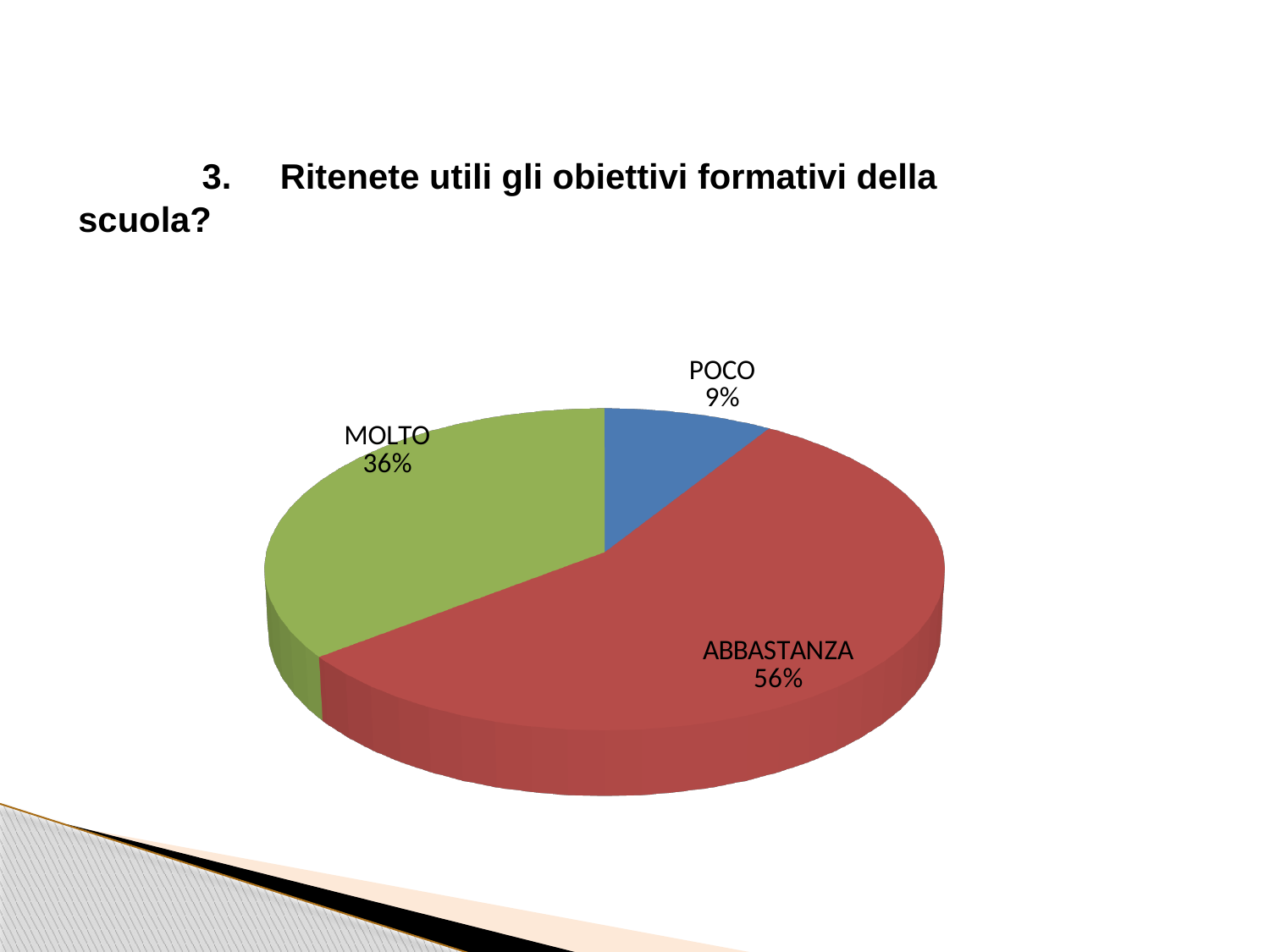
How many slices does the pie chart have? 3 Which is larger, the share for MOLTO or the share for POCO? MOLTO What kind of chart is shown on the slide? pie chart What percentage of respondents answered ABBASTANZA? 56% What colour is the POCO slice? blue What colour is the ABBASTANZA slice? red Which response has the largest share of the pie? ABBASTANZA What is the difference in percentage points between MOLTO and POCO? 27 What percentage of respondents answered POCO? 9% What percentage of respondents answered MOLTO? 36% Which response has the smallest share of the pie? POCO What is the difference in percentage points between ABBASTANZA and MOLTO? 20